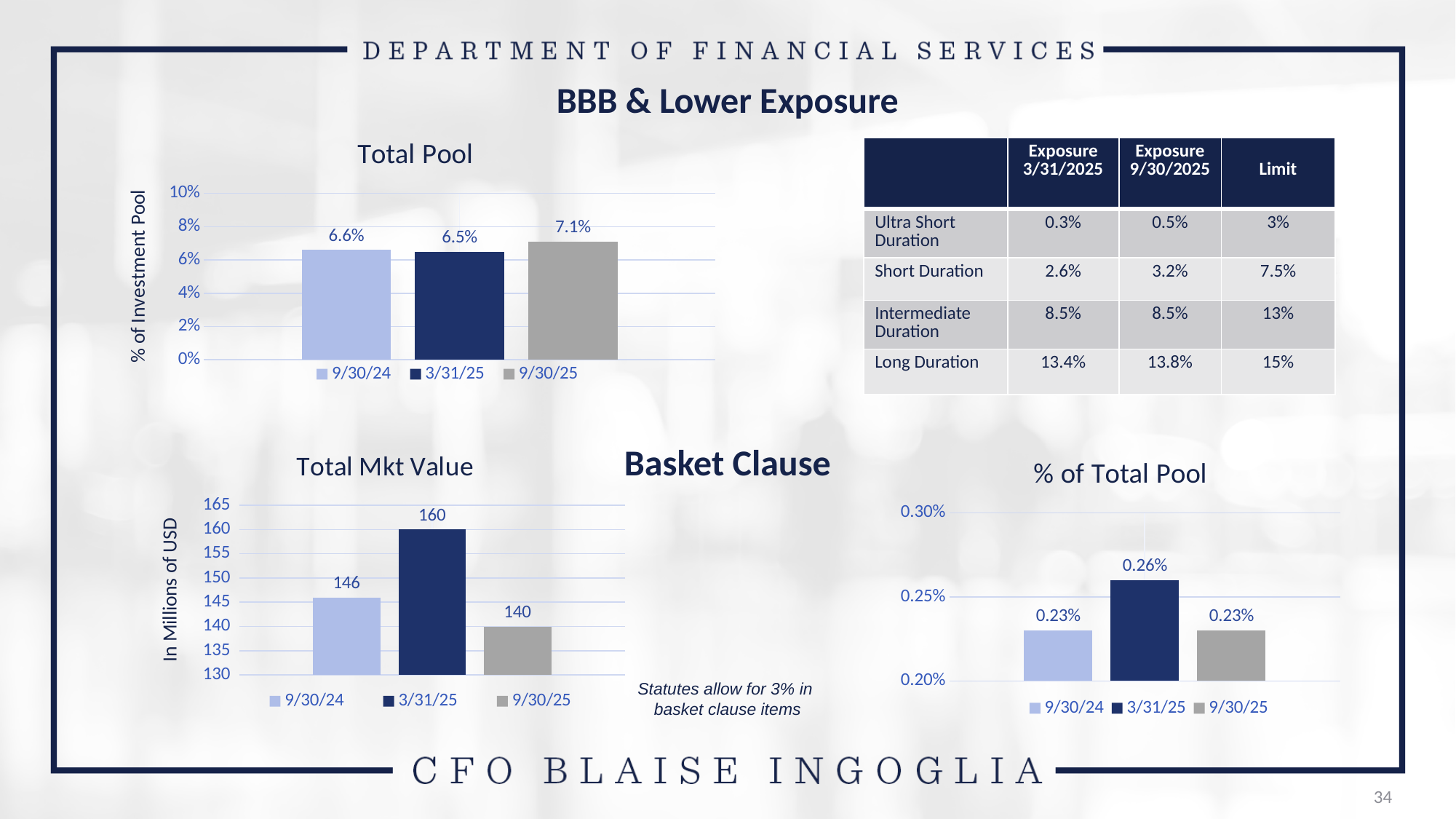
In the Total Mkt Value chart, what is the difference between the 9/30/24 value and the 9/30/25 value? 6 In the Total Pool chart, which date has the lowest value? 3/31/25 In the Total Mkt Value chart, what kind of chart is shown? Bar chart In the Total Mkt Value chart, what is the value for 3/31/25? 160 In the Total Mkt Value chart, what is the y-axis label? In Millions of USD In the Total Pool chart, what is the difference between the 9/30/25 value and the 3/31/25 value? 0.6% In the Total Mkt Value chart, which date has the highest value? 3/31/25 In the % of Total Pool chart, what is the value for 3/31/25? 0.26% In the Total Pool chart, how many series does the legend list? 3 In the Total Pool chart, what is the value for 9/30/25? 7.1% In the % of Total Pool chart, how many bars are plotted? 3 In the % of Total Pool chart, which is larger, the value for 3/31/25 or the value for 9/30/25? 3/31/25